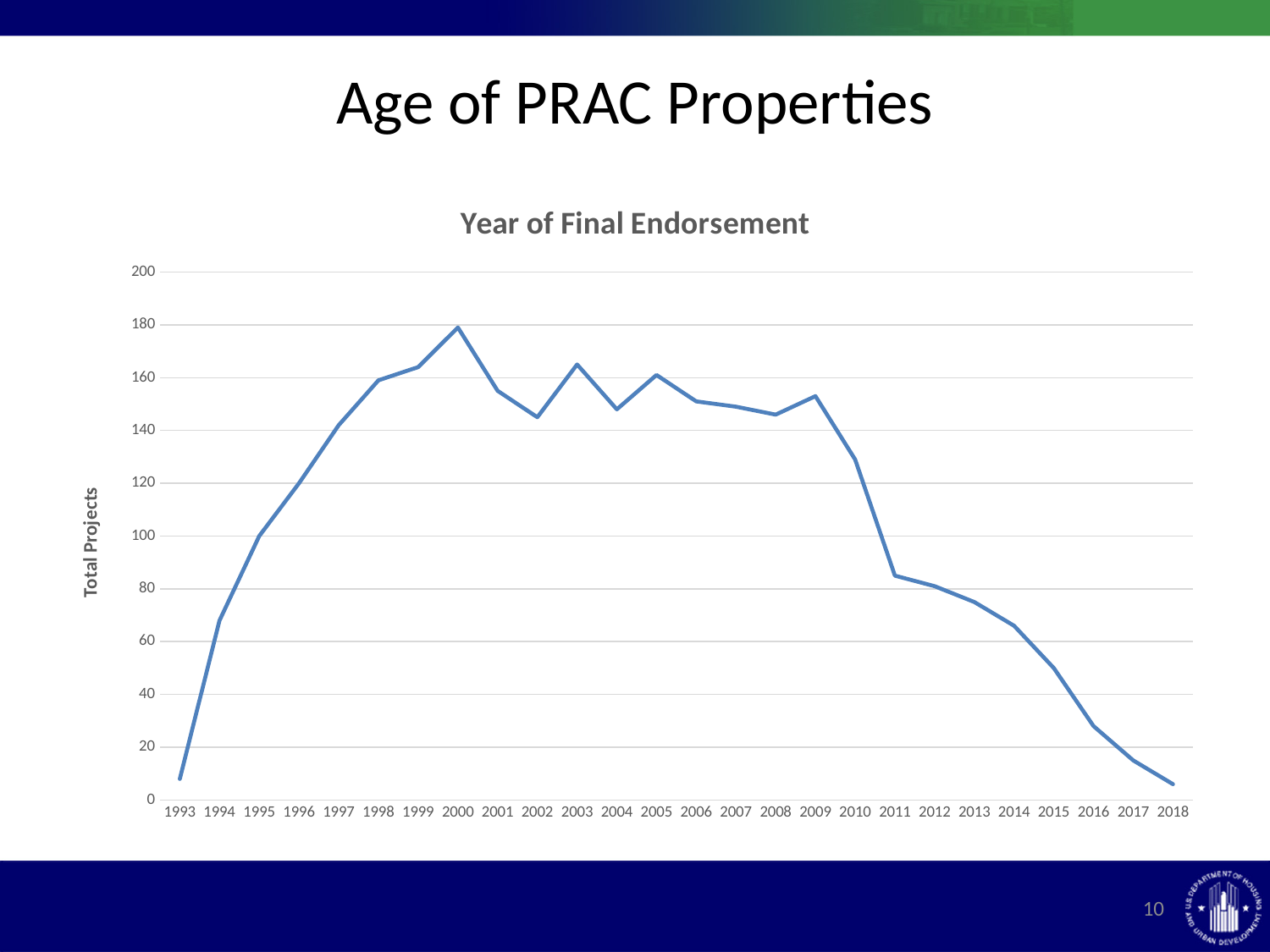
Is the value for 2010 greater or less than 140? less Which year has the larger value, 1995 or 2016? 1995 What is the title of the chart? Year of Final Endorsement Which year has the highest number of total projects? 2000 Is the value for 2016 greater or less than 40? less How many years are plotted along the x axis? 26 What kind of chart is shown on the slide? line chart What is the label on the vertical axis of the chart? Total Projects Which year has the larger value, 2002 or 2003? 2003 Do the values rise or fall from 2009 to 2018? fall Is the value for 1993 greater or less than 20? less